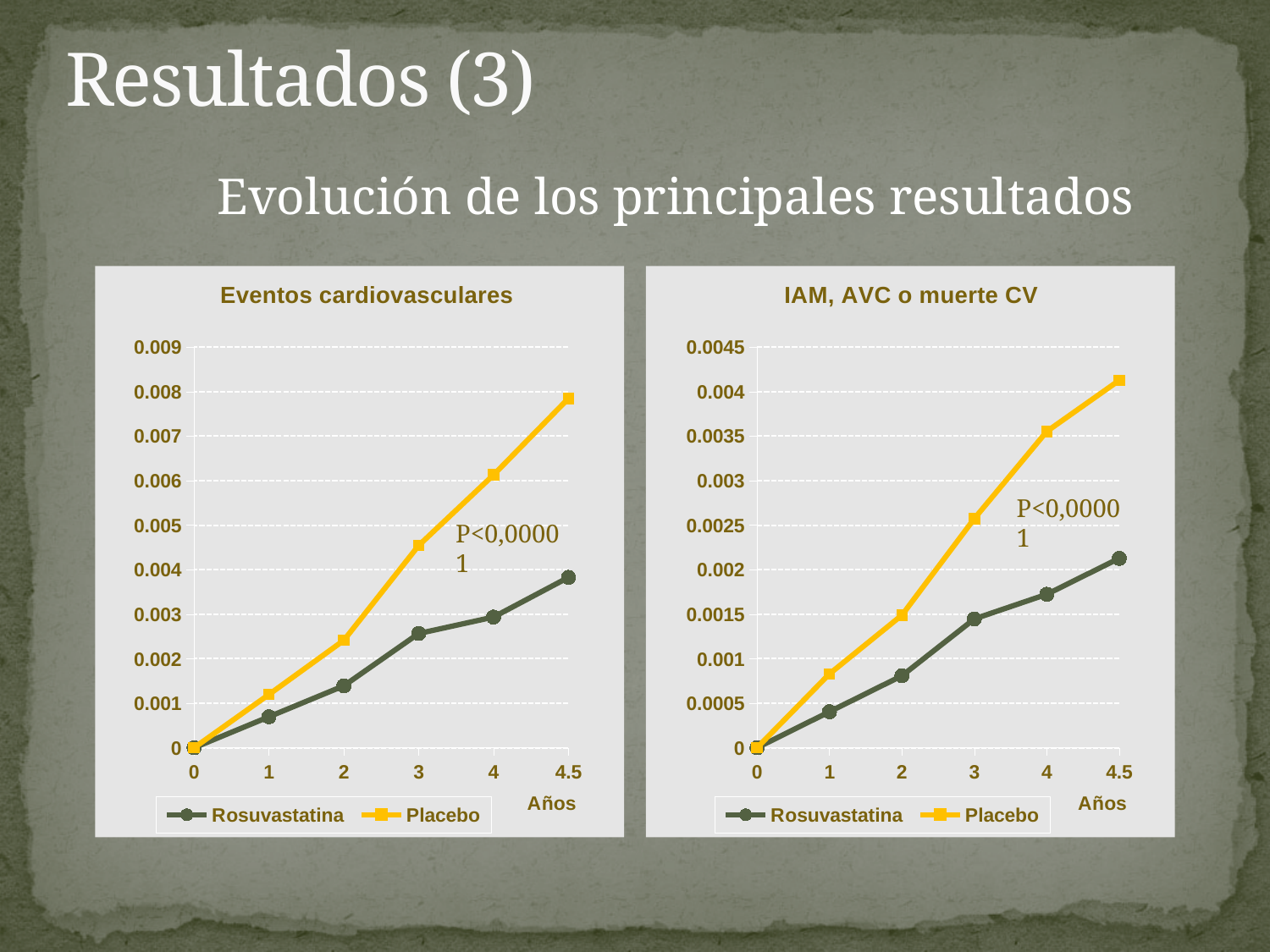
What is the x-axis label on the "Eventos cardiovasculares" chart? Años In the "IAM, AVC o muerte CV" chart, which series has the higher value at 4.5 years, Rosuvastatina or Placebo? Placebo In the "IAM, AVC o muerte CV" chart, what is the Rosuvastatina value at 0 years? 0 In the "Eventos cardiovasculares" chart, is the Placebo value at 3 years greater or less than 0.004? greater In the "Eventos cardiovasculares" chart, do the Placebo values rise or fall as the years increase? rise How many series does the legend of the "IAM, AVC o muerte CV" chart list? 2 In the "Eventos cardiovasculares" chart, is the Placebo value at 4.5 years greater or less than 0.007? greater In the "IAM, AVC o muerte CV" chart, is the Rosuvastatina value at 3 years greater or less than 0.002? less In the "Eventos cardiovasculares" chart, how many time points are plotted along the x axis? 6 What kind of chart is the "Eventos cardiovasculares" chart? line chart